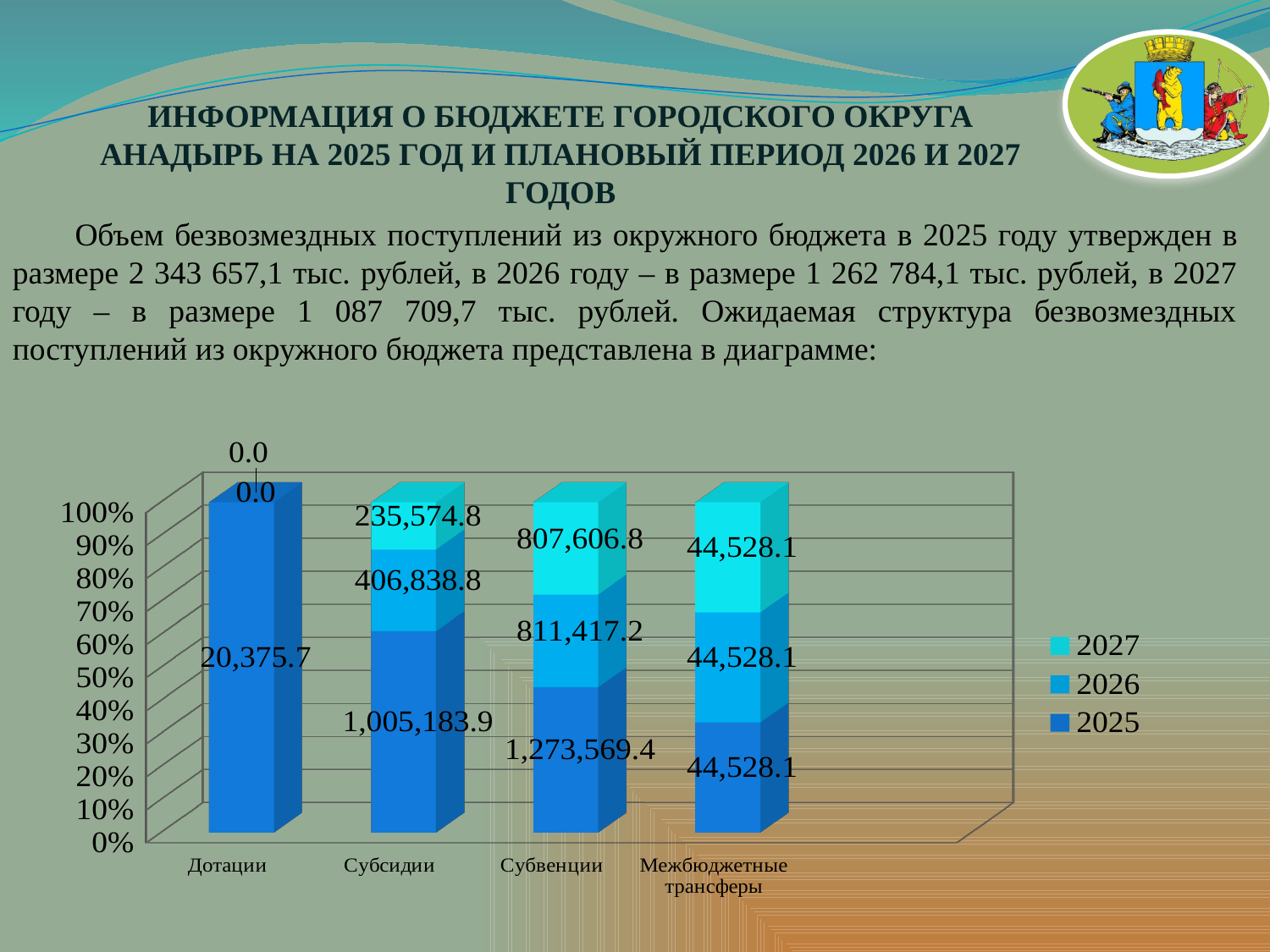
How many series does the legend list? 3 Which is larger: the 2026 value for Субвенции or the 2026 value for Субсидии? Субвенции Which category has the lowest value in the 2025 series? Дотации What is the value for Межбюджетные трансферы in the 2026 series? 44,528.1 What is the difference between the 2025 and 2026 values for Субсидии? 598,345.1 What is the value for Дотации in the 2026 series? 0.0 How many categories are shown on the x axis? 4 Which category has the highest value in the 2025 series? Субвенции What is the value for Субвенции in the 2027 series? 807,606.8 What is the total of the three stacked values for Субсидии? 1,647,597.5 What is the value for Субсидии in the 2025 series? 1,005,183.9 What kind of chart is shown on the slide? Stacked bar chart